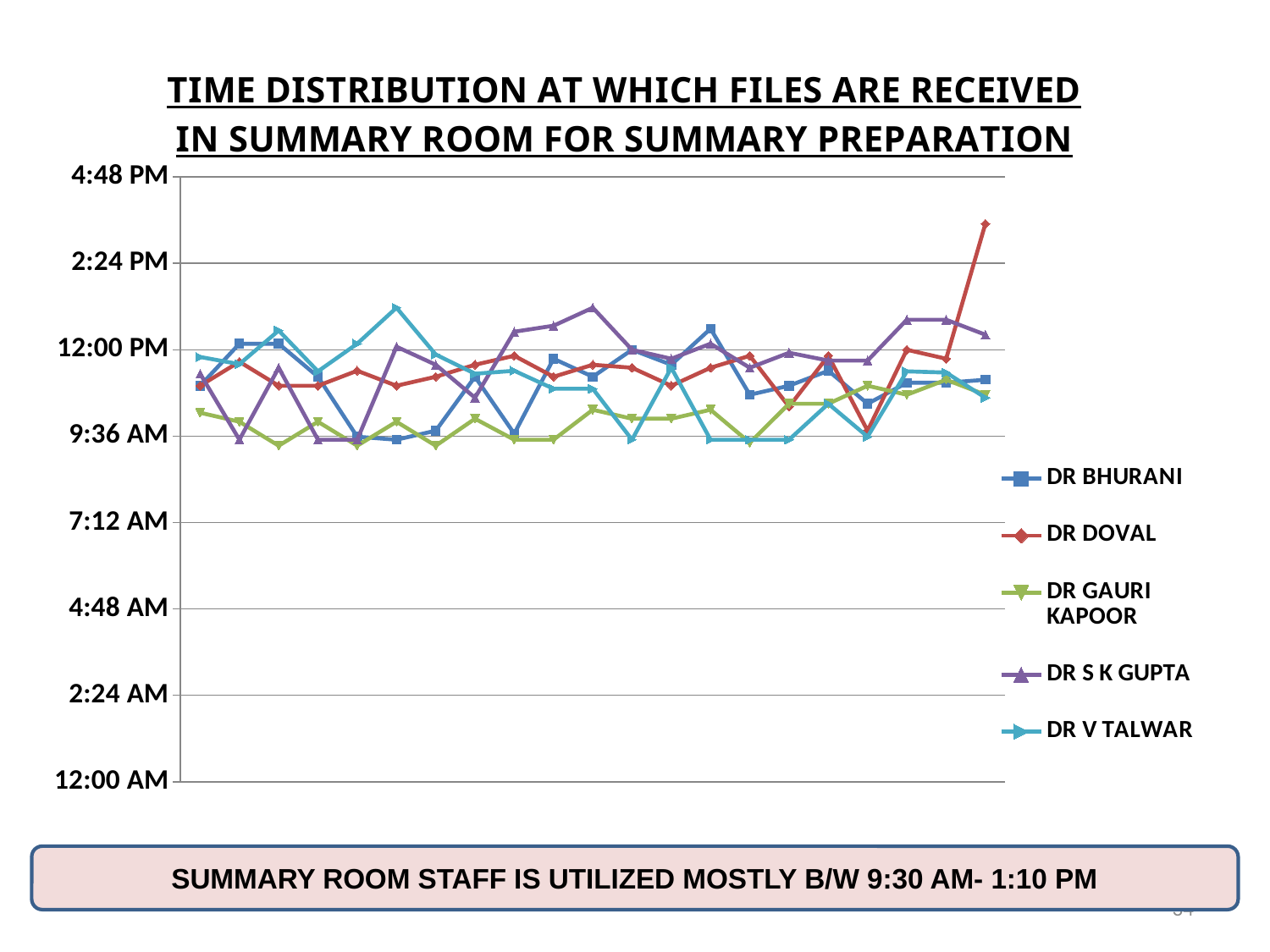
What is the title of the chart? TIME DISTRIBUTION AT WHICH FILES ARE RECEIVED IN SUMMARY ROOM FOR SUMMARY PREPARATION How many series does the legend list? 5 Is the highest point for DR S K GUPTA greater or less than 12:00 PM? greater What kind of chart is shown on the slide? Line chart Is the highest point for DR GAURI KAPOOR greater or less than 12:00 PM? less Is the highest point for DR V TALWAR greater or less than 12:00 PM? greater Which series reaches the highest single point on the chart? DR DOVAL Which series stays lowest on the chart overall? DR GAURI KAPOOR What is the topmost tick label on the vertical axis? 4:48 PM Which series has the highest point: DR DOVAL or DR BHURANI? DR DOVAL